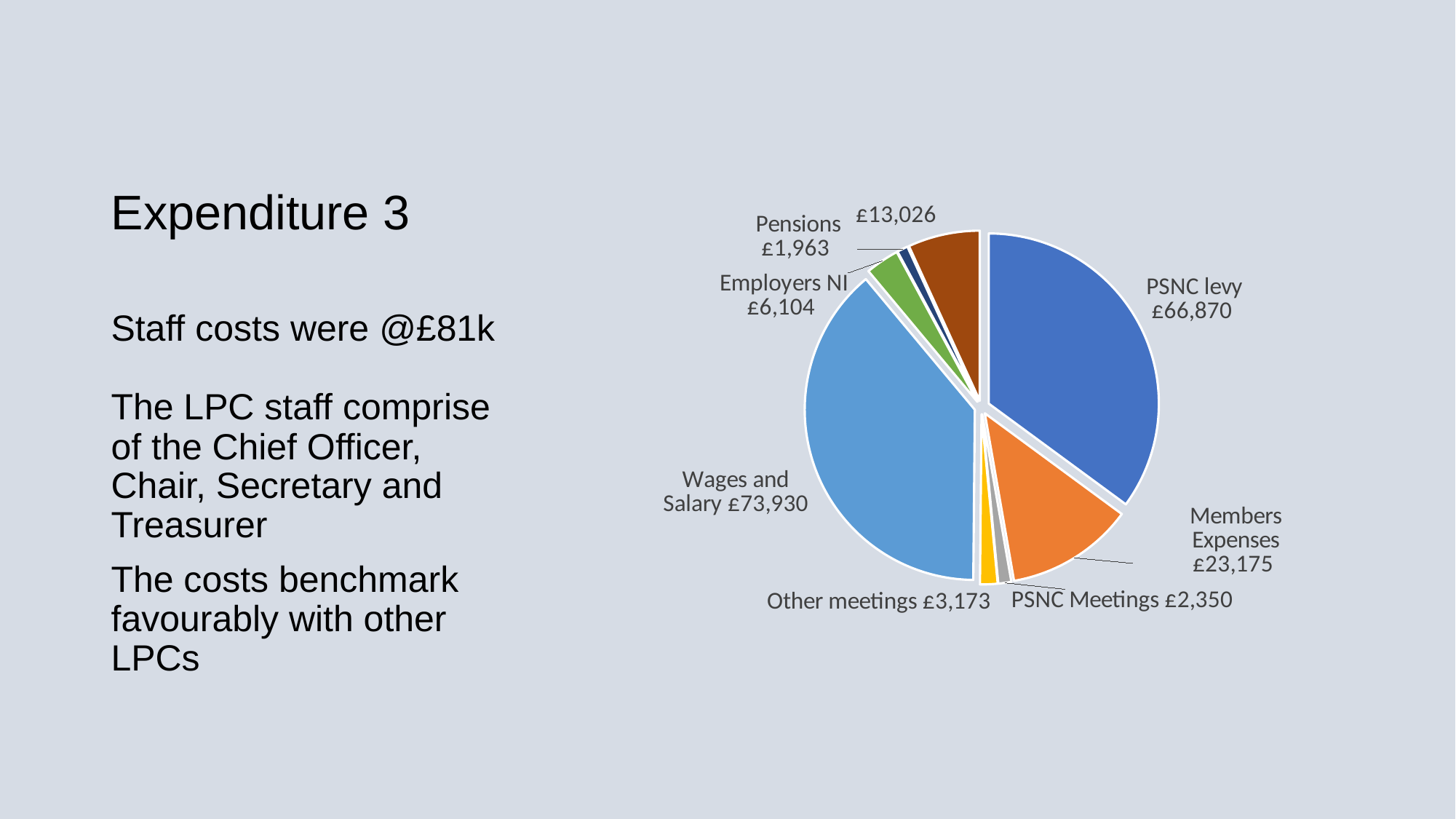
Which labelled category has the smallest slice of the pie? Pensions What kind of chart is shown on the slide? Pie chart What is the value of the Other meetings slice? £3,173 What is the value of the Wages and Salary slice? £73,930 What is the difference between the Wages and Salary value and the PSNC levy value? £7,060 What is the value of the Members Expenses slice? £23,175 How many slices does the pie chart have? 8 Which category has the largest slice of the pie? Wages and Salary What is the value of the PSNC levy slice? £66,870 Which is larger, Other meetings or PSNC Meetings? Other meetings What colour is the PSNC levy slice? Dark blue What is the value of the Employers NI slice? £6,104